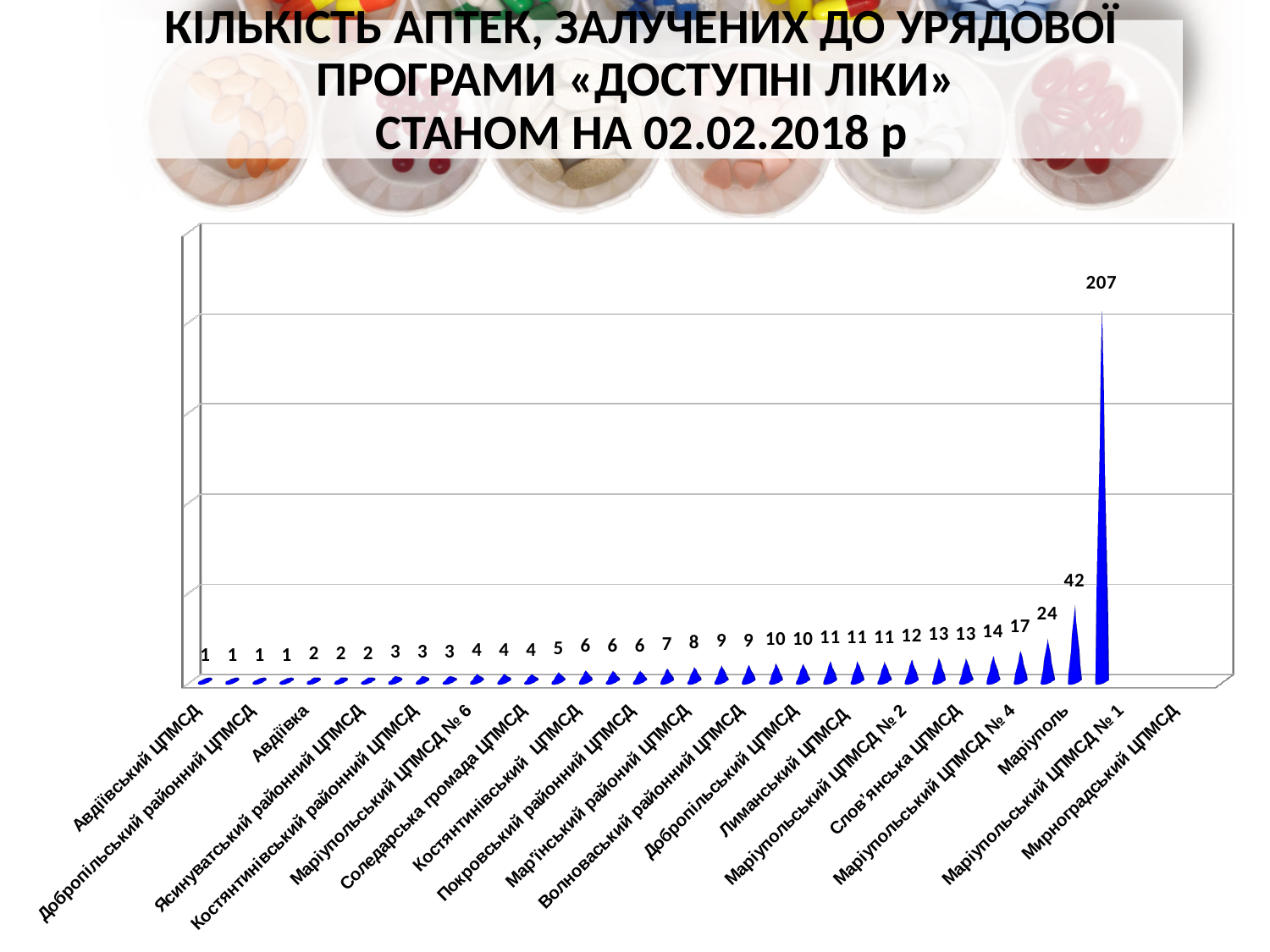
What is the difference between the second-highest value (42) and the third-highest value (24)? 18 What is the difference between the highest value (207) and the second-highest value (42)? 165 Do the values rise or fall from left to right along the x axis? rise What is the value for Авдіївський ЦПМСД? 1 How many data points are plotted on the chart? 34 What is the lowest value shown on the chart? 1 What colour are the bars on the chart? blue Which is larger, the second-highest value or the third-highest value on the chart? the second-highest value (42) What is the highest value shown on the chart? 207 What date is given in the chart title? 02.02.2018 What kind of chart is shown on the slide? bar chart How many data points on the chart have the value 11? 3